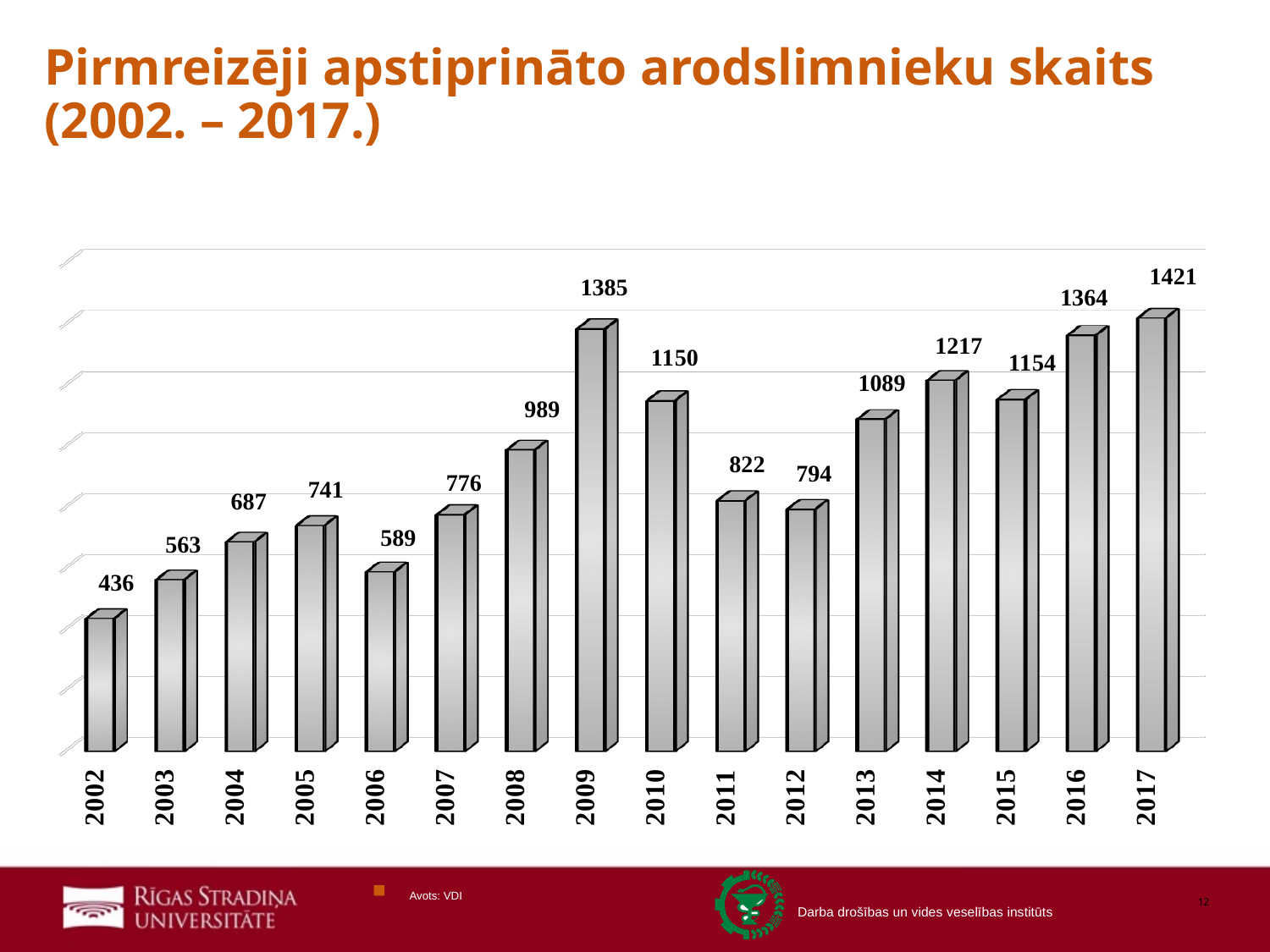
How many years are shown on the x axis? 16 What is the value for 2009? 1385 What is the value for 2013? 1089 Which year has the lowest value? 2002 What kind of chart is shown on the slide? bar chart What is the difference between the values for 2017 and 2016? 57 Which is larger, the value for 2014 or the value for 2015? 2014 Do the values generally rise or fall from 2002 to 2009? rise What is the difference between the values for 2009 and 2010? 235 Which is larger, the value for 2011 or the value for 2012? 2011 What is the value for 2002? 436 Which year has the highest value? 2017